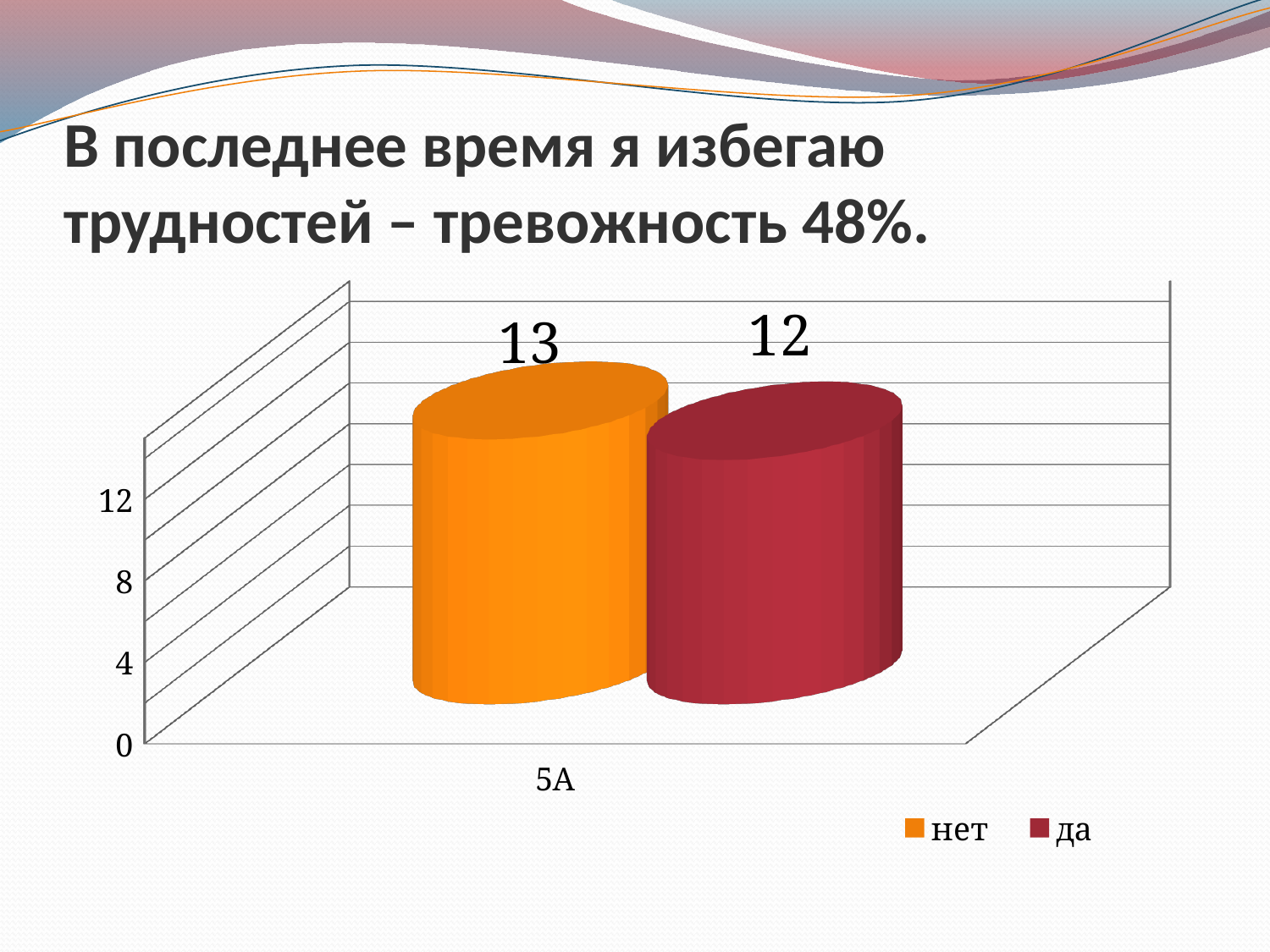
What is the category label on the x axis? 5А How many series does the legend list? 2 What colour represents the "да" series? red How many categories are shown on the x axis? 1 What is the difference between the values for "нет" and "да"? 1 Is the value for "да" greater or less than 8? greater Which series has the higher value for 5А, "нет" or "да"? нет What is the value for "нет" in category 5А? 13 What is the value for "да" in category 5А? 12 Which series has the lowest value on the chart? да What kind of chart is shown on the slide? bar chart